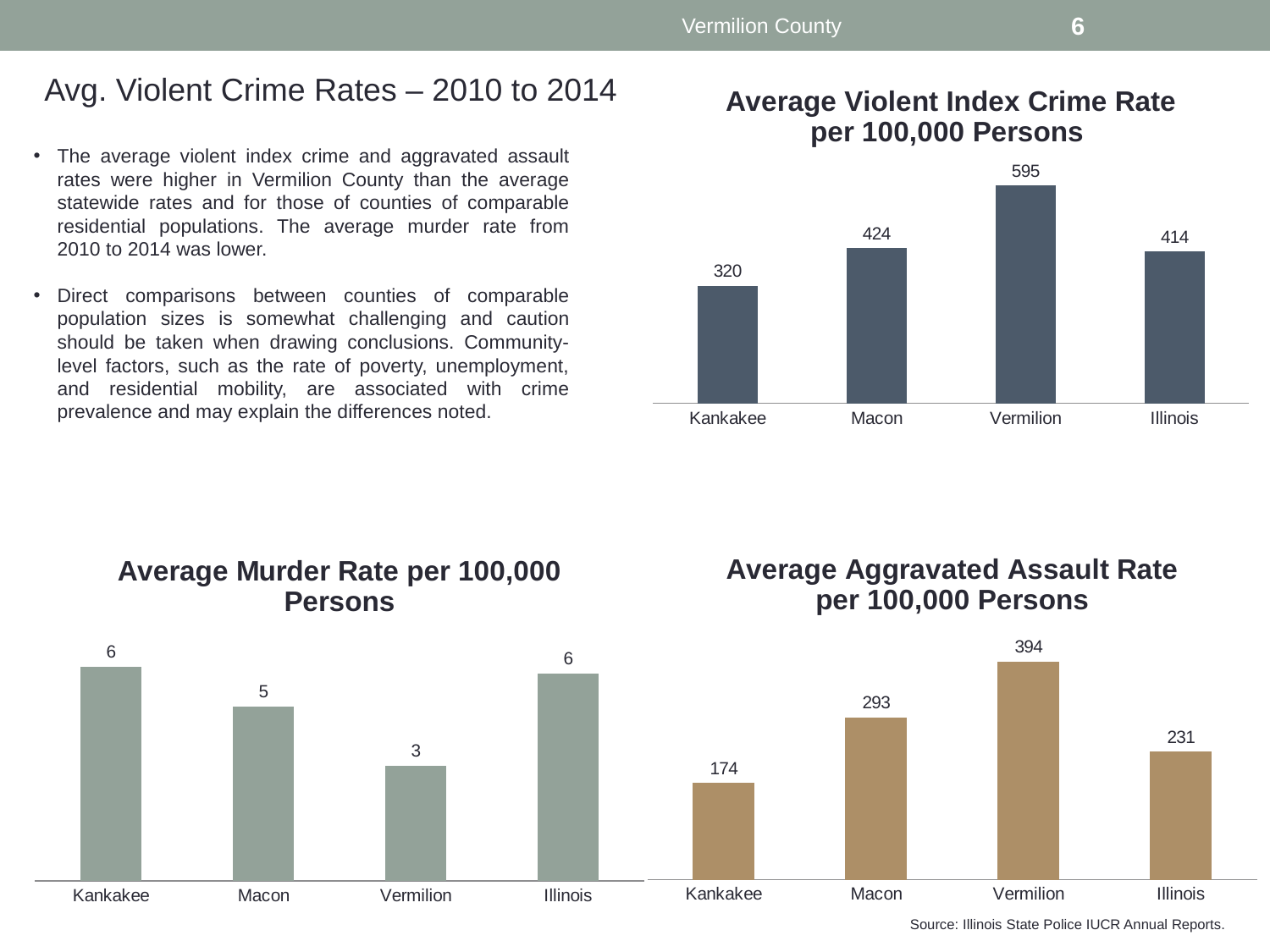
In the Average Aggravated Assault Rate per 100,000 Persons chart, which category has the highest value? Vermilion In the Average Violent Index Crime Rate per 100,000 Persons chart, what is the value for Vermilion? 595 In the Average Violent Index Crime Rate per 100,000 Persons chart, which category has the lowest value? Kankakee In the Average Aggravated Assault Rate per 100,000 Persons chart, what is the value for Kankakee? 174 In the Average Murder Rate per 100,000 Persons chart, which category has the lowest value? Vermilion In the Average Murder Rate per 100,000 Persons chart, what is the value for Vermilion? 3 How many categories are shown in the Average Aggravated Assault Rate per 100,000 Persons chart? 4 In the Average Murder Rate per 100,000 Persons chart, what is the difference between the values for Kankakee and Macon? 1 In the Average Aggravated Assault Rate per 100,000 Persons chart, what is the difference between the values for Macon and Illinois? 62 What kind of chart is the Average Murder Rate per 100,000 Persons chart? Bar chart In the Average Violent Index Crime Rate per 100,000 Persons chart, what is the difference between the values for Vermilion and Illinois? 181 In the Average Violent Index Crime Rate per 100,000 Persons chart, which is larger, the value for Macon or the value for Illinois? Macon